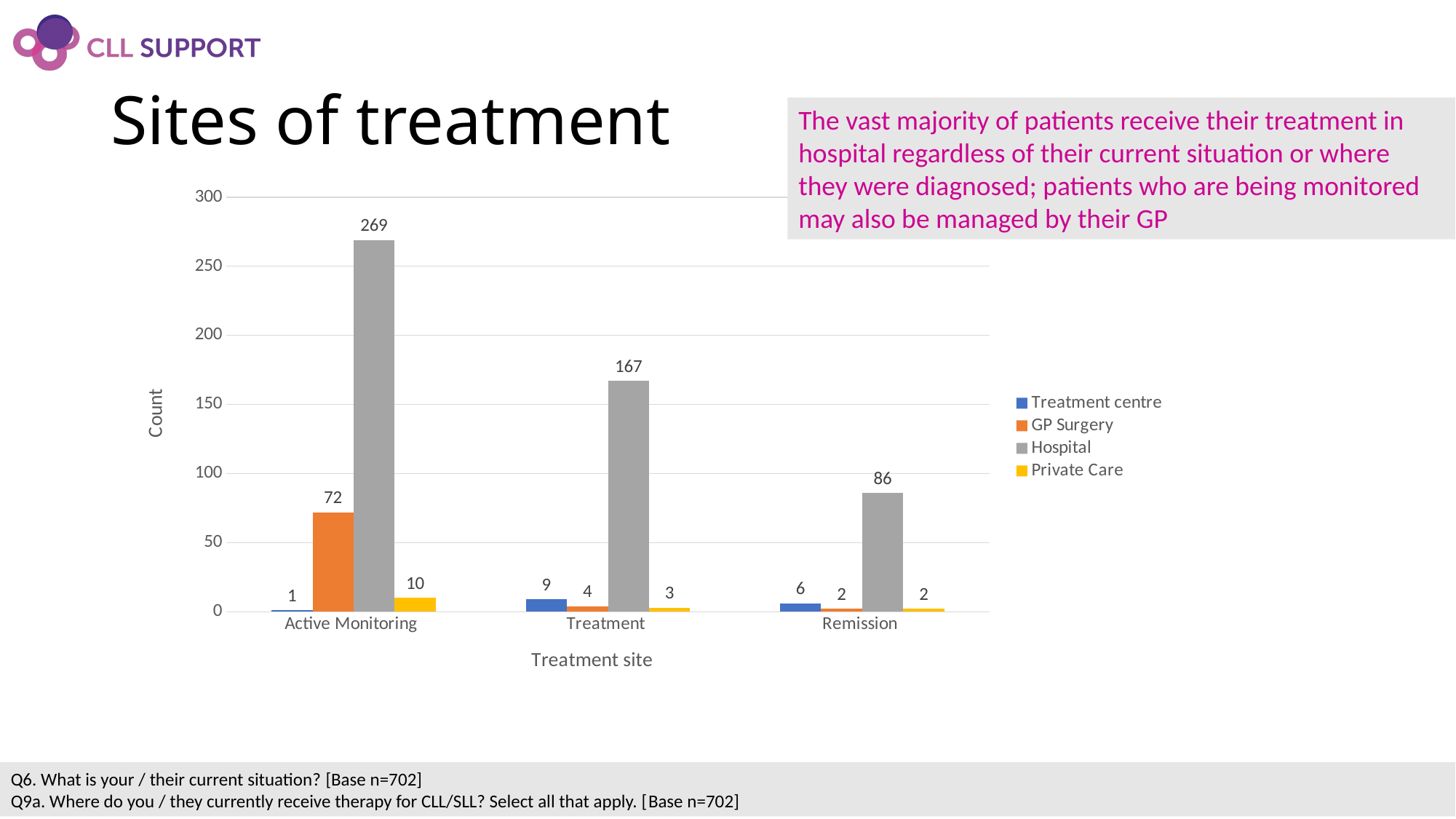
What kind of chart is shown on the slide? Bar chart How many series does the legend list? 4 What is the GP Surgery count for Active Monitoring? 72 What is the Treatment centre count for Treatment? 9 What is the difference between the Hospital counts for Active Monitoring and Treatment? 102 How many treatment site categories are shown on the x axis? 3 What is the Hospital count for Active Monitoring? 269 Which is larger: the GP Surgery count for Active Monitoring or the Hospital count for Remission? Hospital count for Remission Which treatment site has the highest Hospital count? Active Monitoring Which treatment site has the lowest Treatment centre count? Active Monitoring What is the Hospital count for Remission? 86 What is the label of the y axis? Count